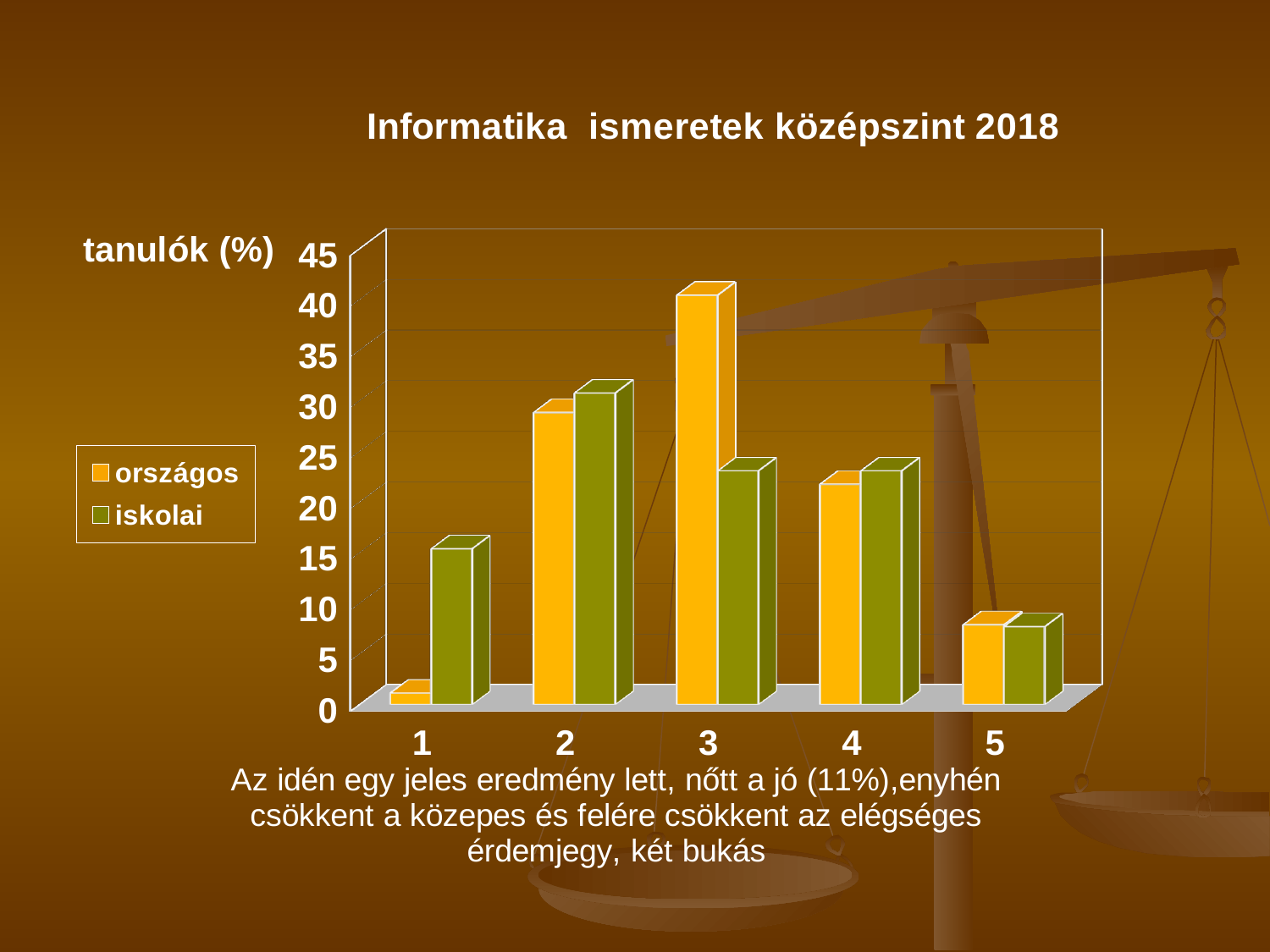
Is the országos value for category 5 greater or less than 10? less Which category has the highest value for the iskolai series? 2 Is the iskolai value for category 1 greater or less than 20? less For category 1, which series has the larger value, országos or iskolai? iskolai How many categories are shown on the x axis? 5 What kind of chart is shown on the slide? bar chart Which category has the highest value for the országos series? 3 For category 3, which series has the larger value, országos or iskolai? országos How many series does the legend list? 2 Is the országos value for category 3 greater or less than 35? greater What is the title of the chart? Informatika ismeretek középszint 2018 Which category has the lowest value for the országos series? 1